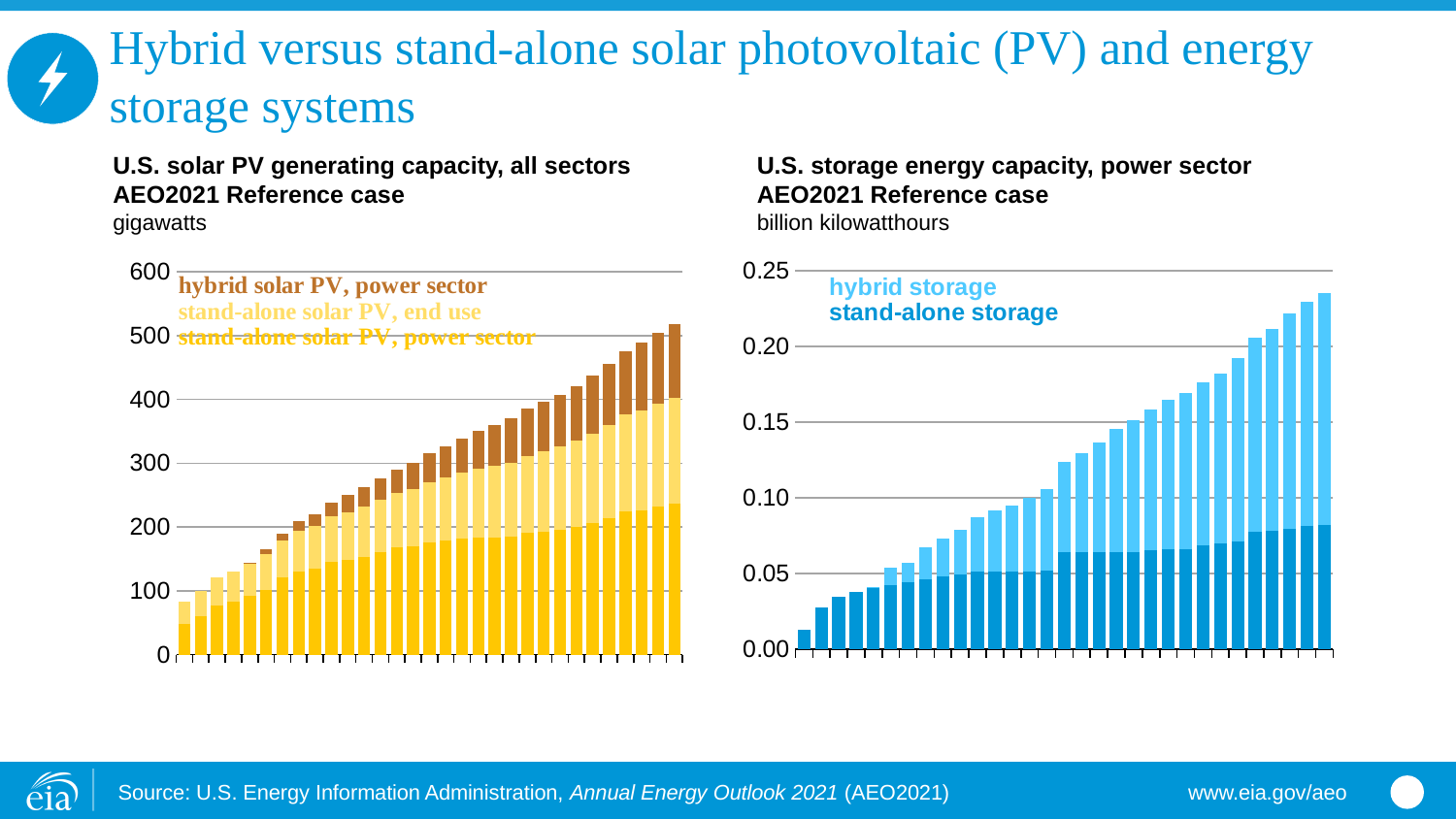
In the left chart, 'U.S. solar PV generating capacity, all sectors', is the total of the leftmost bar greater or less than 100? less How many series does the legend of the left chart, 'U.S. solar PV generating capacity, all sectors', list? 3 What unit is shown on the y axis of the right chart, 'U.S. storage energy capacity, power sector'? billion kilowatthours How many series does the legend of the right chart, 'U.S. storage energy capacity, power sector', list? 2 In the right chart, 'U.S. storage energy capacity, power sector', is the total of the leftmost bar greater or less than 0.05? less What kind of chart is the left chart, 'U.S. solar PV generating capacity, all sectors'? Stacked bar chart What unit is shown on the y axis of the left chart, 'U.S. solar PV generating capacity, all sectors'? gigawatts In the right chart, 'U.S. storage energy capacity, power sector', do the total bar heights rise or fall from left to right? Rise What kind of chart is the right chart, 'U.S. storage energy capacity, power sector'? Stacked bar chart In the right chart, 'U.S. storage energy capacity, power sector', is the total of the rightmost bar greater or less than 0.20? greater In the left chart, 'U.S. solar PV generating capacity, all sectors', do the total bar heights rise or fall from left to right? Rise